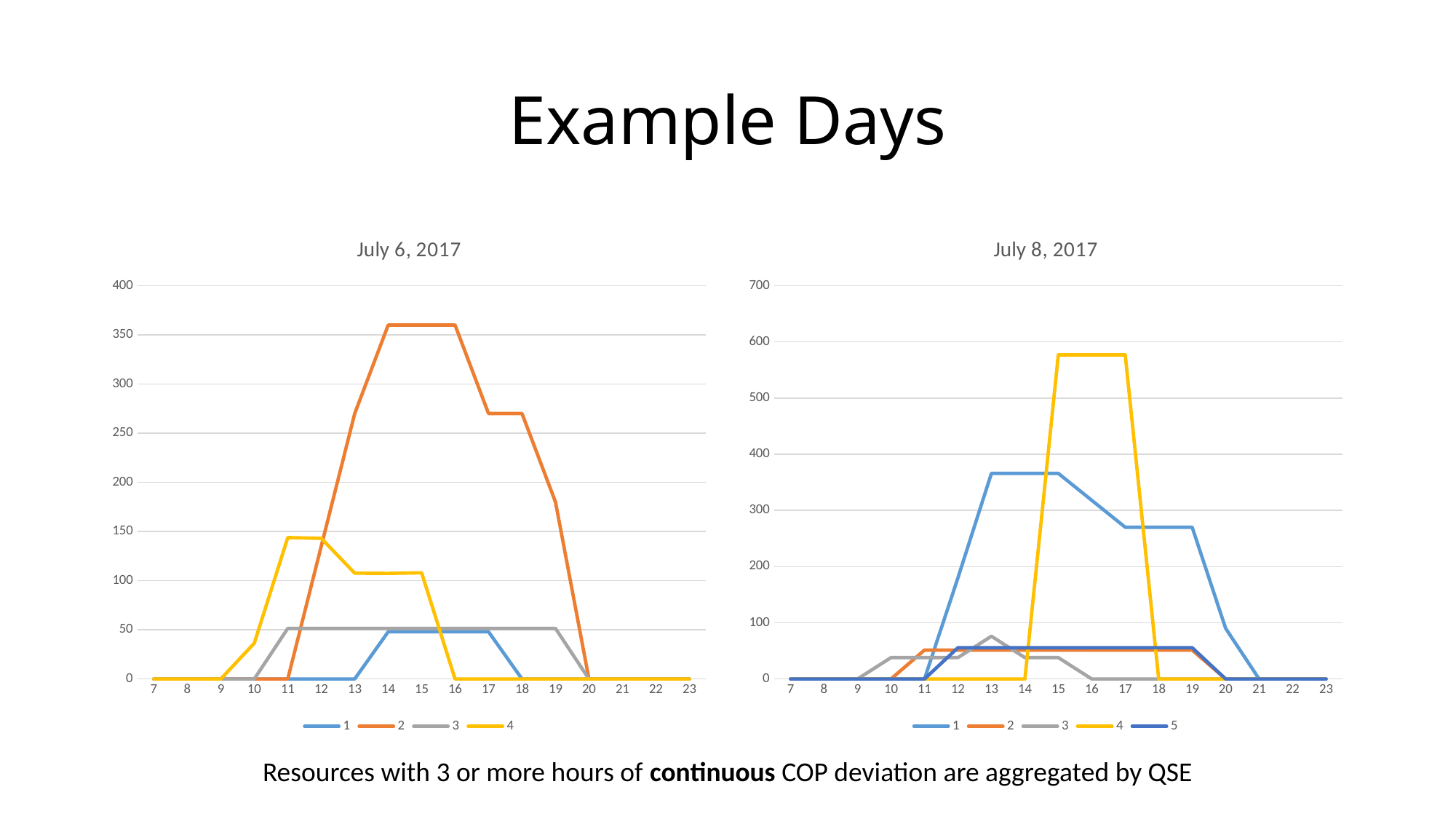
How many series does the legend of the July 8, 2017 chart list? 5 How many hour labels are shown on the x axis of the July 8, 2017 chart? 17 In the July 6, 2017 chart, is the value of series 4 at hour 11 greater or less than 100? greater In the July 8, 2017 chart, which series reaches the highest peak? 4 In the July 8, 2017 chart, what is the value of series 4 at hour 12? 0 In the July 6, 2017 chart, which series reaches the highest peak? 2 In the July 8, 2017 chart, is the value of series 4 at hour 16 greater or less than 500? greater In the July 6, 2017 chart, is the value of series 2 at hour 15 greater or less than 300? greater In the July 6, 2017 chart, at hour 14, which is larger: series 2 or series 4? series 2 How many series does the legend of the July 6, 2017 chart list? 4 What kind of chart is the July 6, 2017 chart? line chart